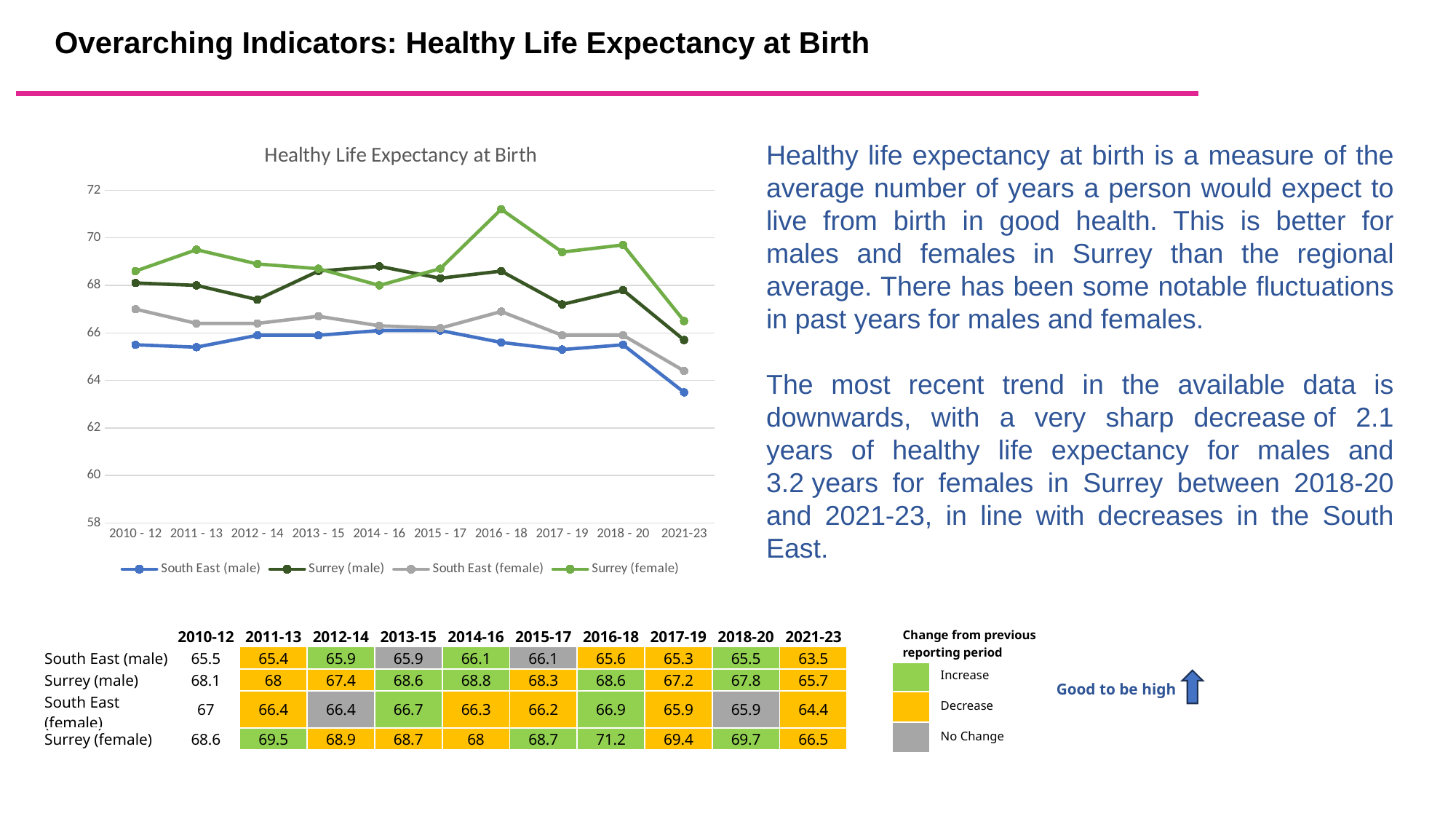
Does the Surrey (female) series rise or fall between 2018-20 and 2021-23? fall Which is larger in 2012-14: Surrey (male) or South East (female)? Surrey (male) What is the title of the chart? Healthy Life Expectancy at Birth What type of chart is shown on the slide? line chart What is the healthy life expectancy value for South East (male) in 2021-23? 63.5 How many series does the chart legend list? 4 What is the healthy life expectancy value for Surrey (female) in 2016-18? 71.2 Which series has the lowest value in 2021-23? South East (male) Which series has the highest value in 2016-18? Surrey (female) What is the difference between Surrey (female) and South East (female) in 2021-23? 2.1 What is the healthy life expectancy value for Surrey (male) in 2014-16? 68.8 How many time periods are plotted along the x axis of the chart? 10